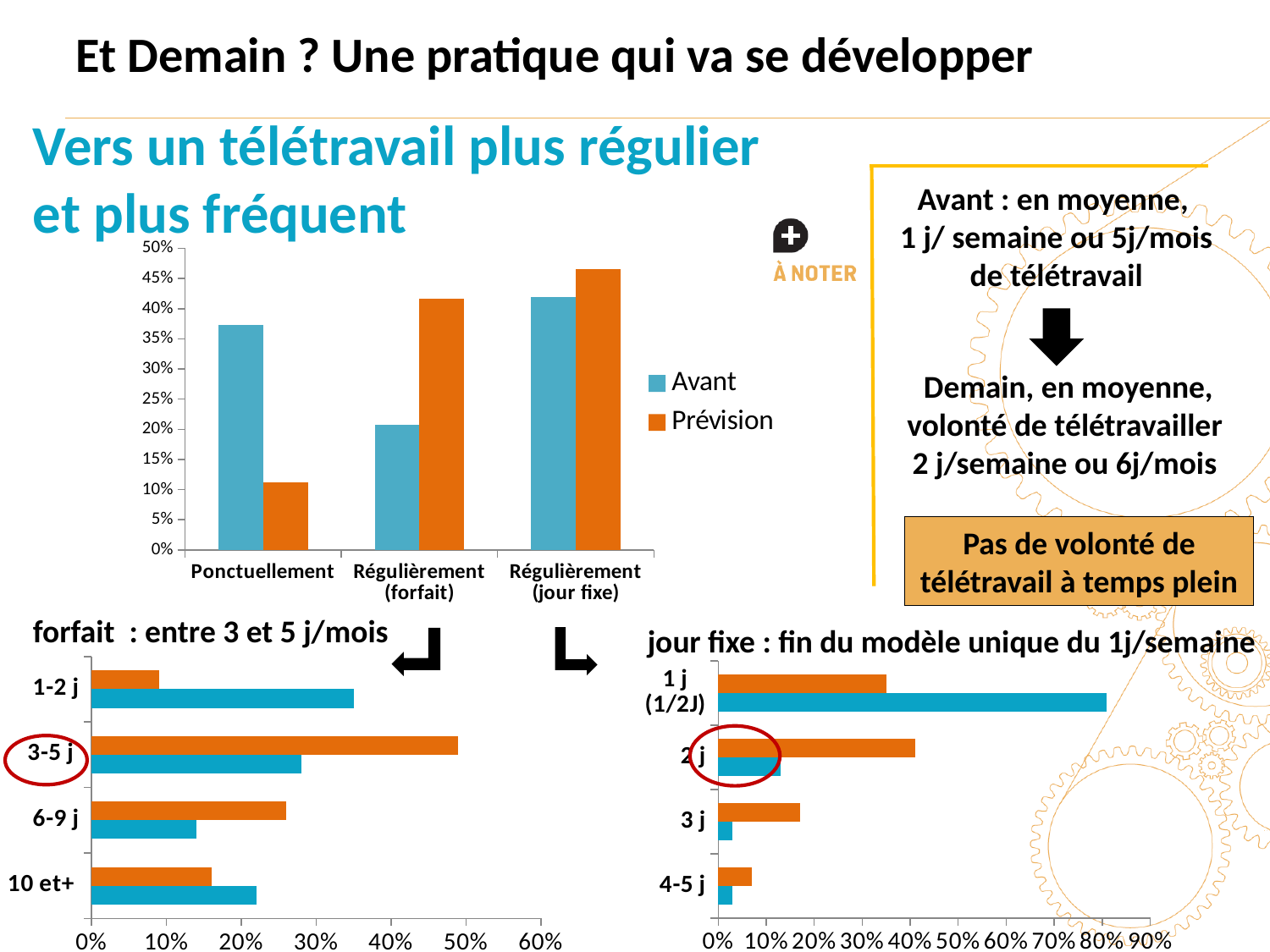
In the top-left chart, how many categories are shown on the x axis? 3 In the top-left chart, what type of chart is shown? bar chart In the bottom-left chart titled 'forfait : entre 3 et 5 j/mois', which category has the longest orange bar? 3-5 j In the top-left chart, is the Prévision value for Ponctuellement greater or less than 15%? less In the top-left chart, which category has the highest Prévision value? Régulièrement (jour fixe) In the bottom-right chart titled 'jour fixe : fin du modèle unique du 1j/semaine', is the blue bar for 1 j (1/2J) greater or less than 70%? greater In the top-left chart, is the Avant value for Ponctuellement greater or less than 30%? greater In the top-left chart, which category has the lowest Avant value? Régulièrement (forfait) In the top-left chart, how many series does the legend list? 2 In the top-left chart, for Régulièrement (forfait), which is larger: Avant or Prévision? Prévision In the bottom-right chart titled 'jour fixe : fin du modèle unique du 1j/semaine', how many categories are shown? 4